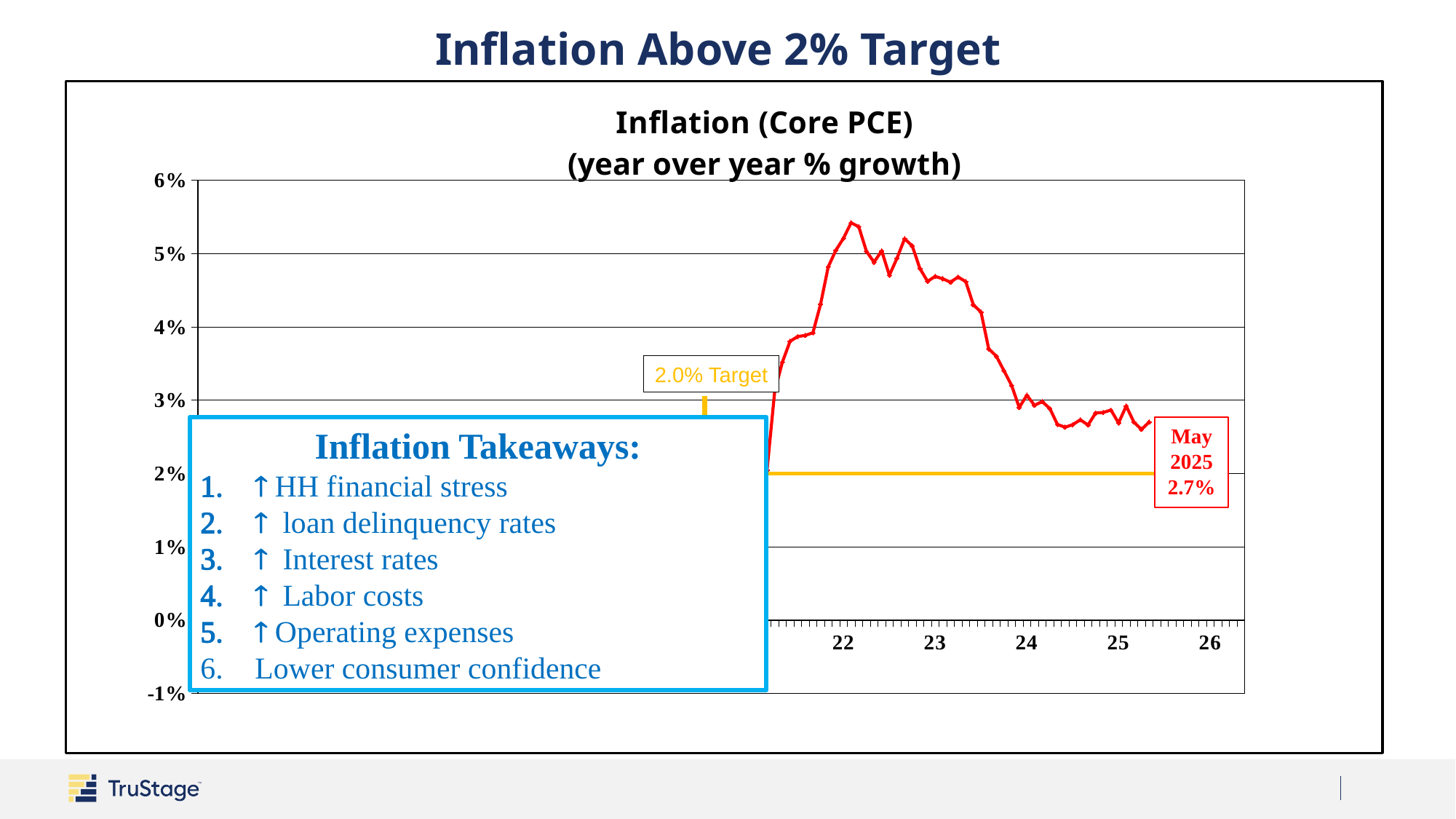
What inflation target is marked by the horizontal line on the chart? 2.0% What is the Core PCE inflation value labelled for May 2025? 2.7% Is the May 2025 inflation value greater or less than 3%? less What kind of chart is shown on the slide? line chart From its 2022 peak to 2025, does the inflation line rise or fall? fall By how much does the May 2025 value exceed the 2.0% target? 0.7% Which is larger, the May 2025 inflation value or the 2.0% target? May 2025 value Is the inflation value at the start of 2023 greater or less than 4%? greater What does the yellow horizontal line on the chart represent? 2.0% Target What is the title of the chart? Inflation (Core PCE) (year over year % growth) Is the peak of the inflation line in 2022 greater or less than 5%? greater